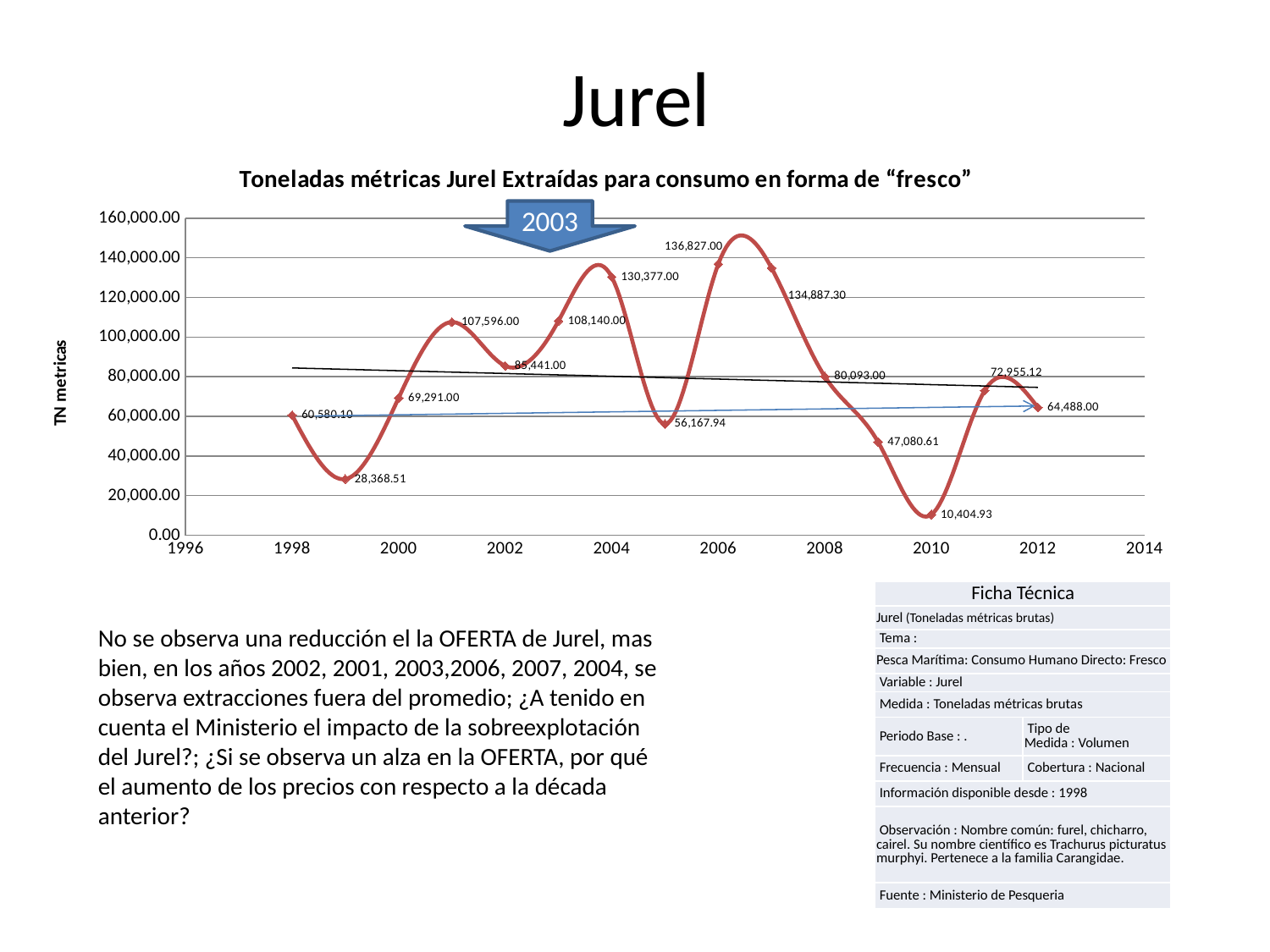
Which is larger, the value for 2001 or the value for 2002? 2001 What is the value plotted for 2003? 108,140.00 Is the value for 2009 greater or less than 60,000.00? less What is the value plotted for 1998? 60,580.10 How many data points are plotted on the chart? 15 What type of chart is shown on the slide? Line chart What is the difference between the values for 2001 and 2000? 38,305.00 Which year has the highest value on the chart? 2006 What is the difference between the values for 2004 and 2003? 22,237.00 Do the values rise or fall from 2007 to 2010? fall What is the value plotted for 2010? 10,404.93 Which year has the lowest value on the chart? 2010